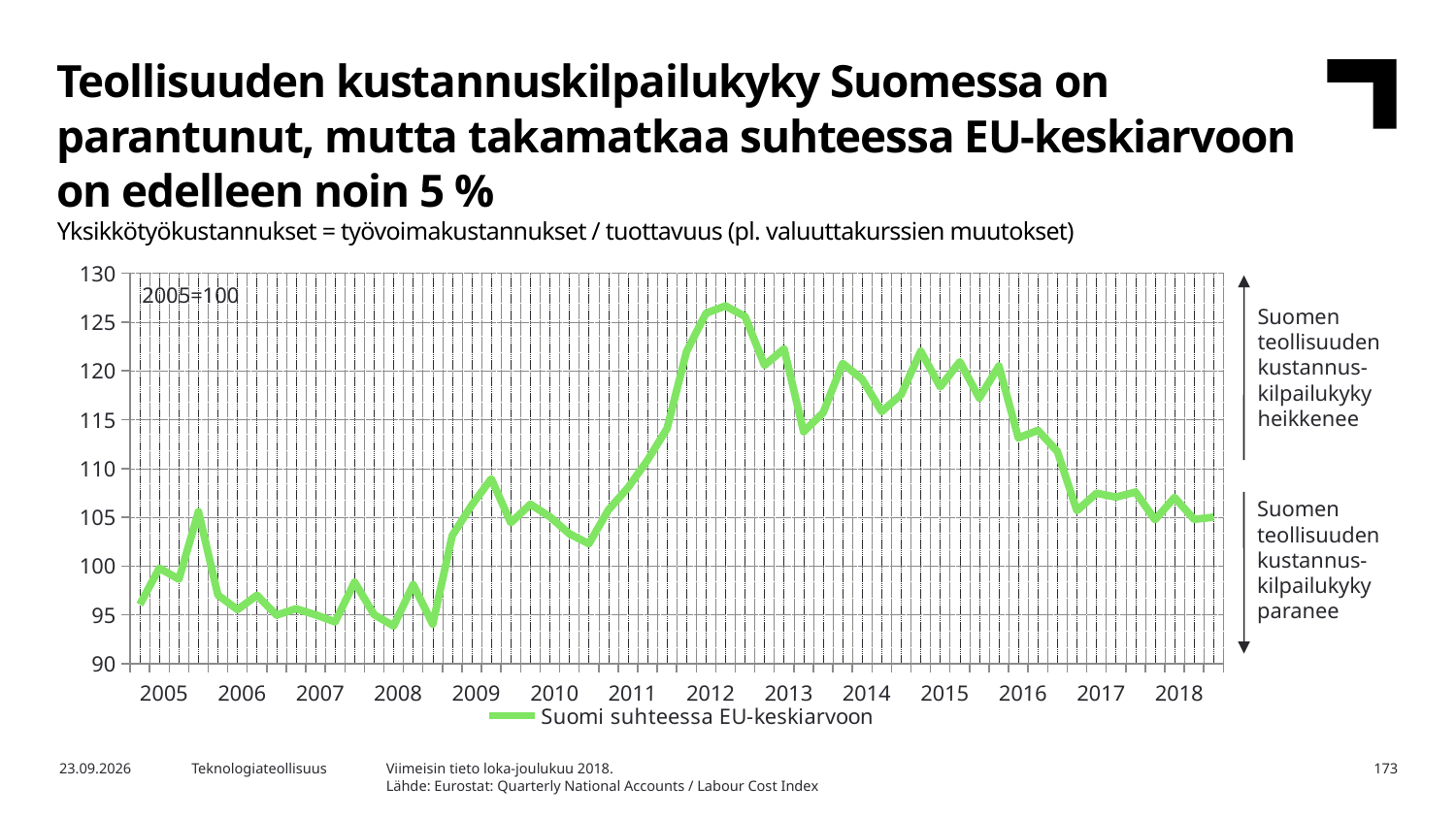
What kind of chart is shown on the slide? line chart Does the line rise or fall between 2008 and 2012? rise How many years are labelled on the x axis? 14 Does the line rise or fall between 2012 and 2018? fall Is the value at the start of 2005 greater or less than 100? less Is the peak value of the line in 2012 greater or less than 120? greater What base year and value is the index set to, as noted in the chart? 2005=100 What is the name of the series shown in the legend? Suomi suhteessa EU-keskiarvoon Is the lowest value of the line in 2008 greater or less than 100? less In which year does the line reach its highest value? 2012 How many series does the legend list? 1